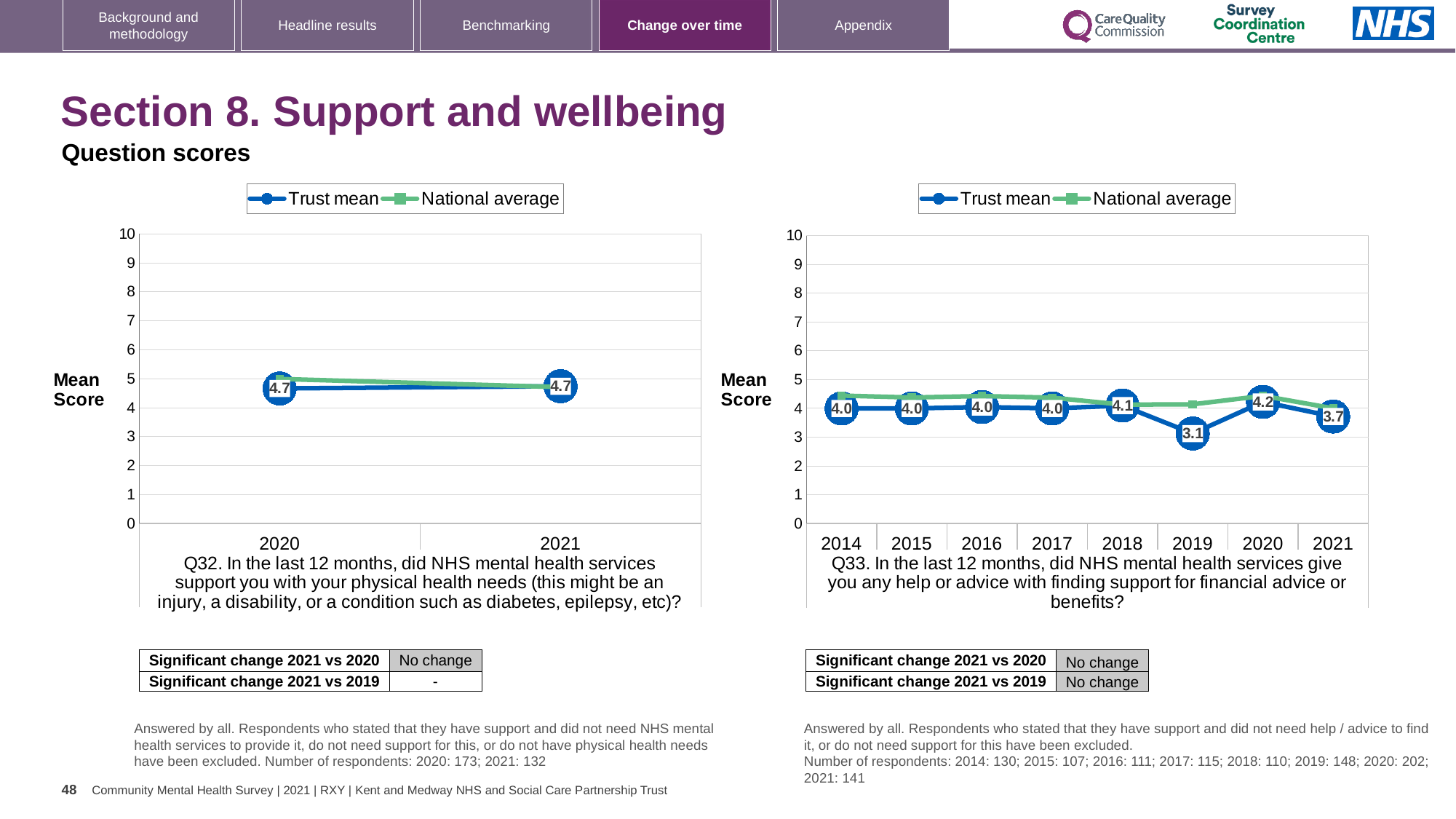
On the Q33 chart (right), what is the Trust mean for 2021? 3.7 On the Q33 chart (right), is the Trust mean for 2018 larger or smaller than the Trust mean for 2019? larger On the Q32 chart (left), how many series does the legend list? 2 On the Q33 chart (right), what is the Trust mean for 2019? 3.1 On the Q32 chart (left), what is the Trust mean for 2021? 4.7 On the Q33 chart (right), what is the difference between the Trust mean for 2020 and the Trust mean for 2019? 1.1 What type of chart is the Q33 chart (right)? Line chart On the Q33 chart (right), which year has the highest Trust mean? 2020 On the Q33 chart (right), which year has the lowest Trust mean? 2019 On the Q33 chart (right), how many years are shown on the x axis? 8 On the Q32 chart (left), what is the Trust mean for 2020? 4.7 On the Q33 chart (right), what is the Trust mean for 2020? 4.2